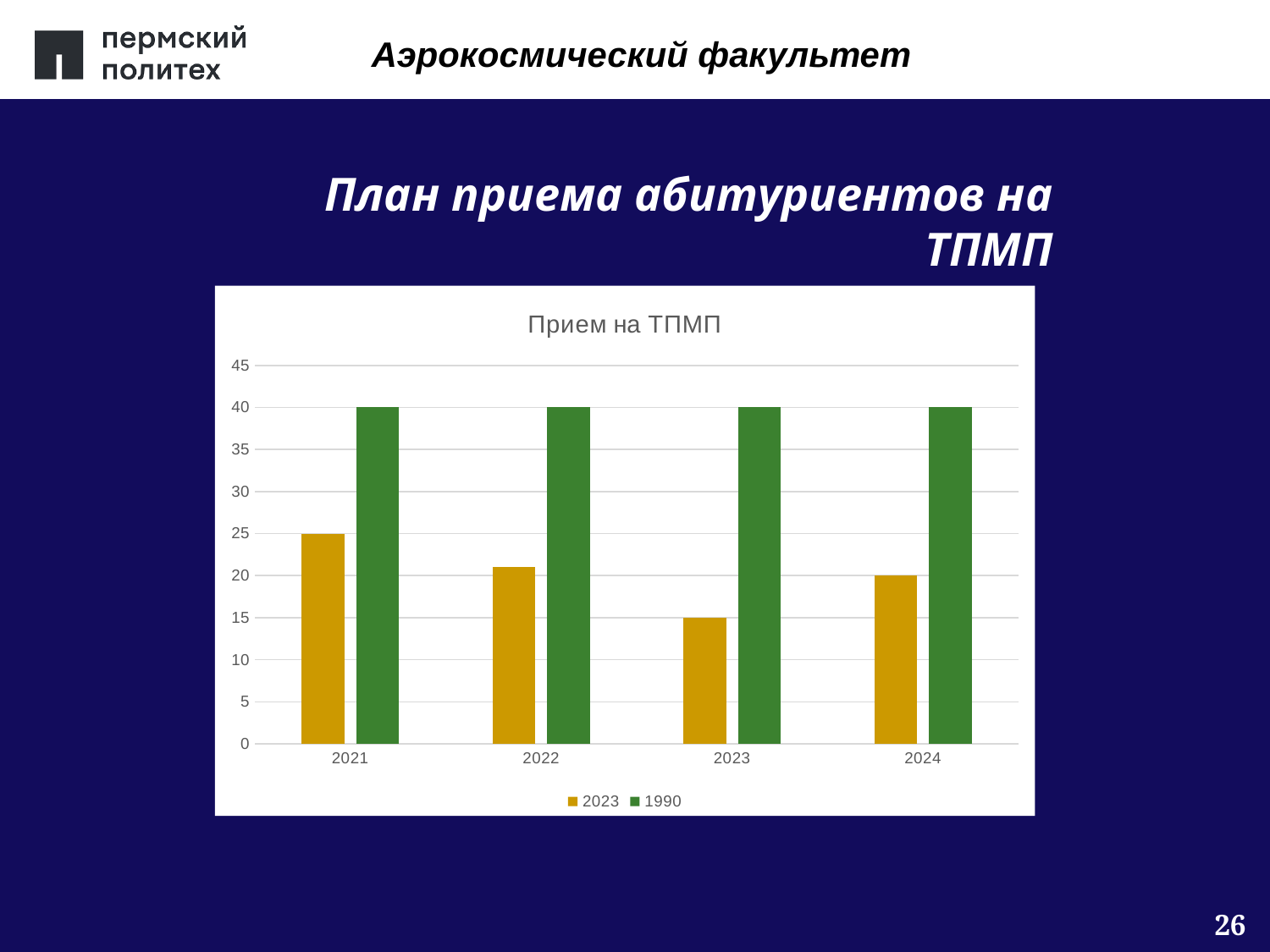
What is the value of the 2023 series for 2024? 20 Is the value of the 2023 series for 2022 greater or less than 25? less What is the value of the 2023 series for 2021? 25 What is the value of the 2023 series for 2023? 15 Which category has the lowest value in the 2023 series? 2023 How many series does the legend list? 2 What kind of chart is shown on the slide? bar chart How many categories are shown on the x axis? 4 What is the title of the chart? Прием на ТПМП What is the difference between the 1990 series and the 2023 series for 2021? 15 What is the value of the 1990 series for 2021? 40 Which is larger for 2024: the 2023 series or the 1990 series? 1990